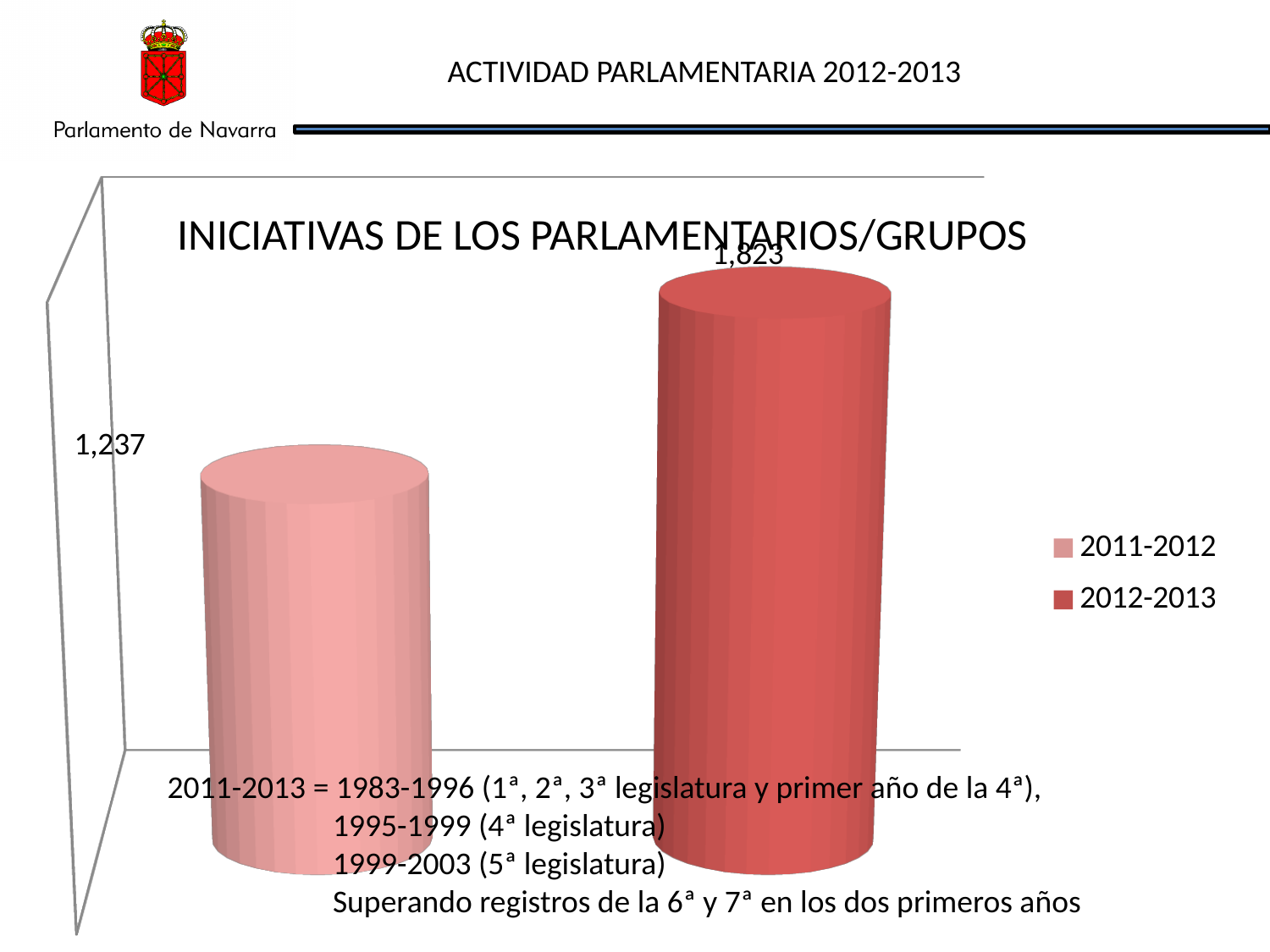
What is the title of the chart? INICIATIVAS DE LOS PARLAMENTARIOS/GRUPOS What is the value for 2011-2012 in the chart? 1,237 Which is larger, the value for 2011-2012 or the value for 2012-2013? 2012-2013 What is the difference between the values for 2012-2013 and 2011-2012? 586 What is the value for 2012-2013 in the chart? 1,823 Do the values rise or fall from 2011-2012 to 2012-2013? Rise Which series has the lowest value in the chart? 2011-2012 Which legend entry is shown in the darker red colour? 2012-2013 How many series does the legend list? 2 Which series has the highest value in the chart? 2012-2013 How many bars are plotted in the chart? 2 What kind of chart is shown on the slide? Bar chart